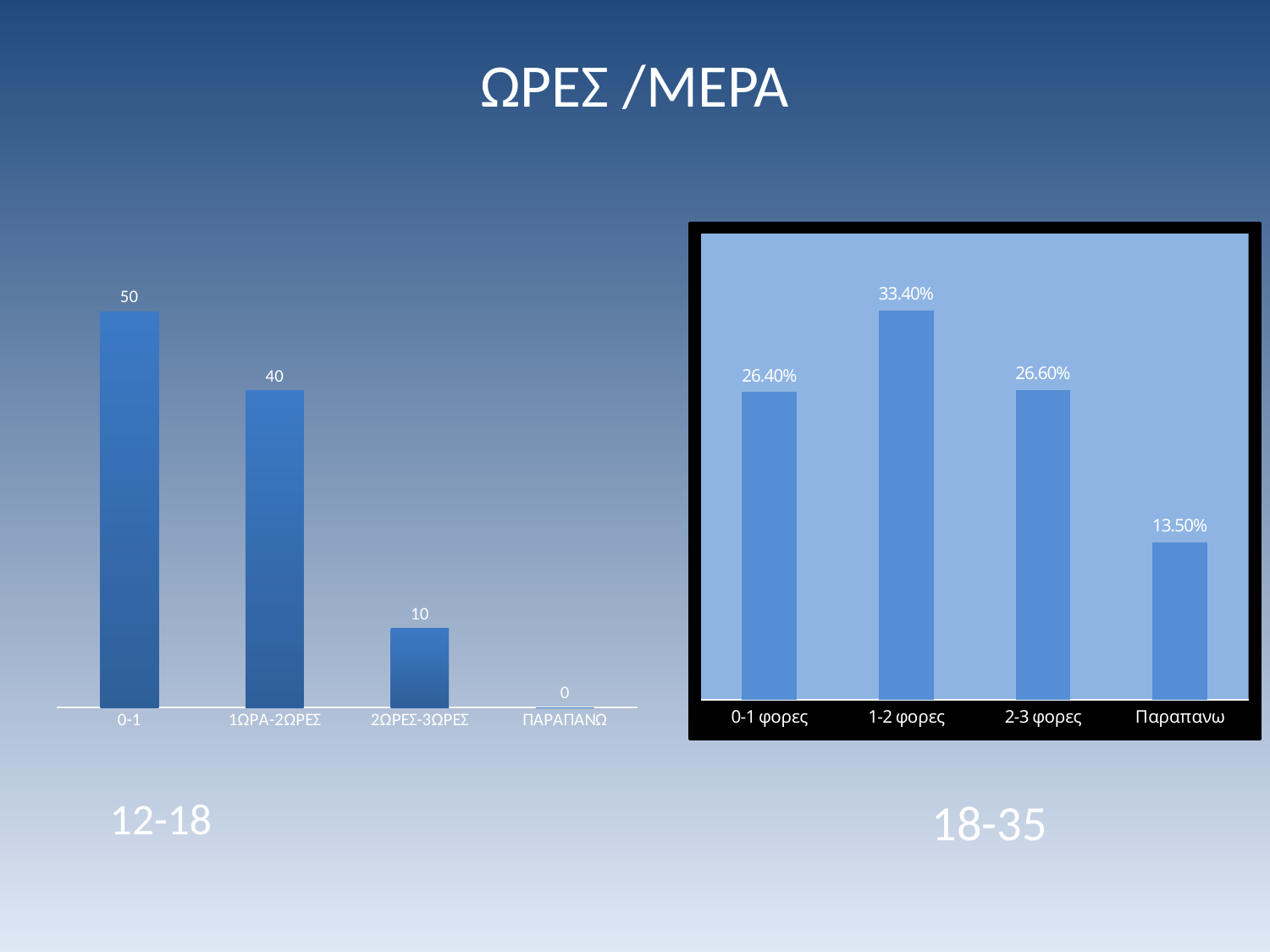
In the left chart (12-18), which category has the highest value? 0-1 In the right chart (18-35), what is the value for 1-2 φορες? 33.40% In the right chart (18-35), which category has the highest value? 1-2 φορες In the left chart (12-18), how many categories are shown on the x axis? 4 What kind of chart is the right chart (18-35)? Bar chart In the left chart (12-18), what is the value for 2ΩΡΕΣ-3ΩΡΕΣ? 10 In the left chart (12-18), which category has the lowest value? ΠΑΡΑΠΑΝΩ In the left chart (12-18), what is the difference between the values for 0-1 and 1ΩΡΑ-2ΩΡΕΣ? 10 In the right chart (18-35), what is the difference between the values for 1-2 φορες and Παραπανω? 19.90% In the right chart (18-35), what is the value for Παραπανω? 13.50% In the right chart (18-35), which is larger, the value for 0-1 φορες or 2-3 φορες? 2-3 φορες In the left chart (12-18), what is the value for 0-1? 50